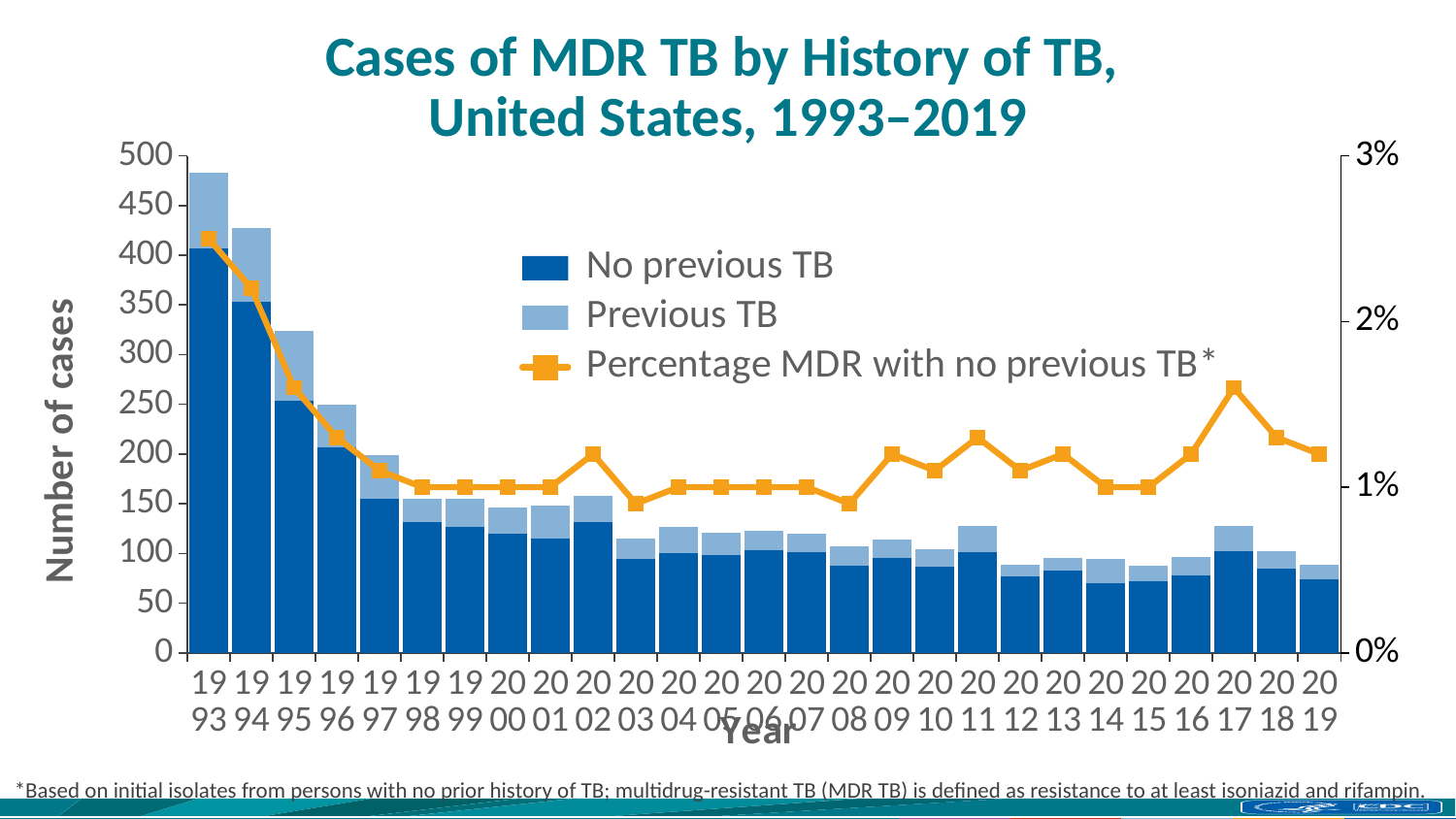
How many years are shown on the x axis? 27 Is the total number of cases in 2019 greater or less than 100? less How many series does the legend list? 3 Is the percentage MDR with no previous TB in 1993 greater or less than 2%? greater What is the label on the left vertical axis? Number of cases Do the total number of cases rise or fall from 1993 to 1998? fall Which year has the highest total number of MDR TB cases? 1993 Is the percentage MDR with no previous TB in 2017 greater or less than 1%? greater What is the title of the chart? Cases of MDR TB by History of TB, United States, 1993–2019 Which year has the larger total number of cases, 1993 or 2019? 1993 What kind of chart is this? stacked bar chart with a line